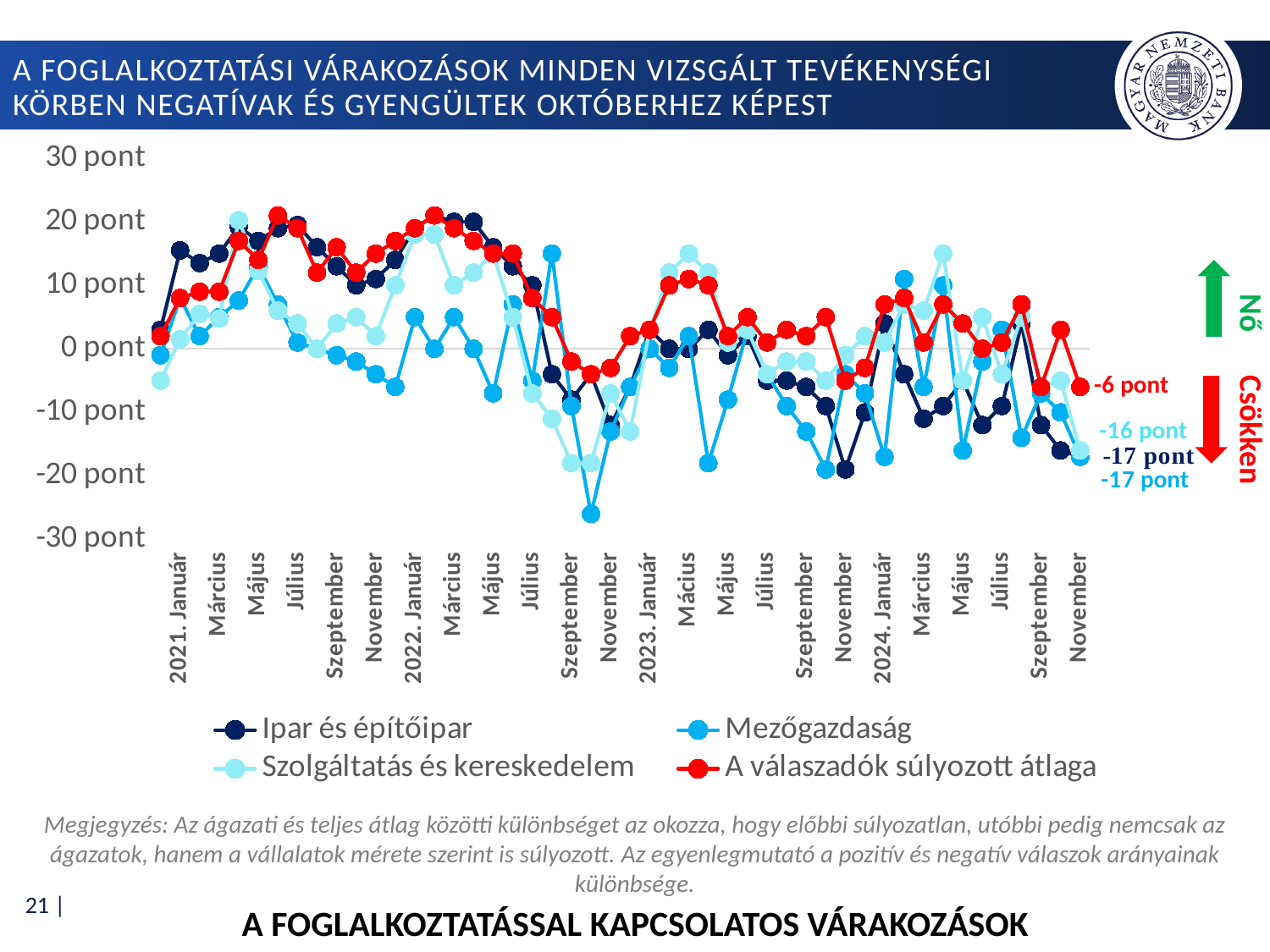
What kind of chart is shown on the slide? line chart What colour is the line for A válaszadók súlyozott átlaga? red What is the latest (November 2024) value for Szolgáltatás és kereskedelem? -16 pont How many series does the legend list? 4 At November 2024, which is larger: the value for Szolgáltatás és kereskedelem or the value for Ipar és építőipar? Szolgáltatás és kereskedelem What is the latest (November 2024) value for Mezőgazdaság? -17 pont Is the value for Ipar és építőipar in November 2024 greater or less than -10 pont? less What is the difference between the November 2024 values of A válaszadók súlyozott átlaga and Szolgáltatás és kereskedelem? 10 pont Which series has the highest value at the end of the period (November 2024)? A válaszadók súlyozott átlaga What is the latest (November 2024) value for Ipar és építőipar? -17 pont What is the latest (November 2024) value for A válaszadók súlyozott átlaga? -6 pont What is the difference between the November 2024 values of A válaszadók súlyozott átlaga and Ipar és építőipar? 11 pont